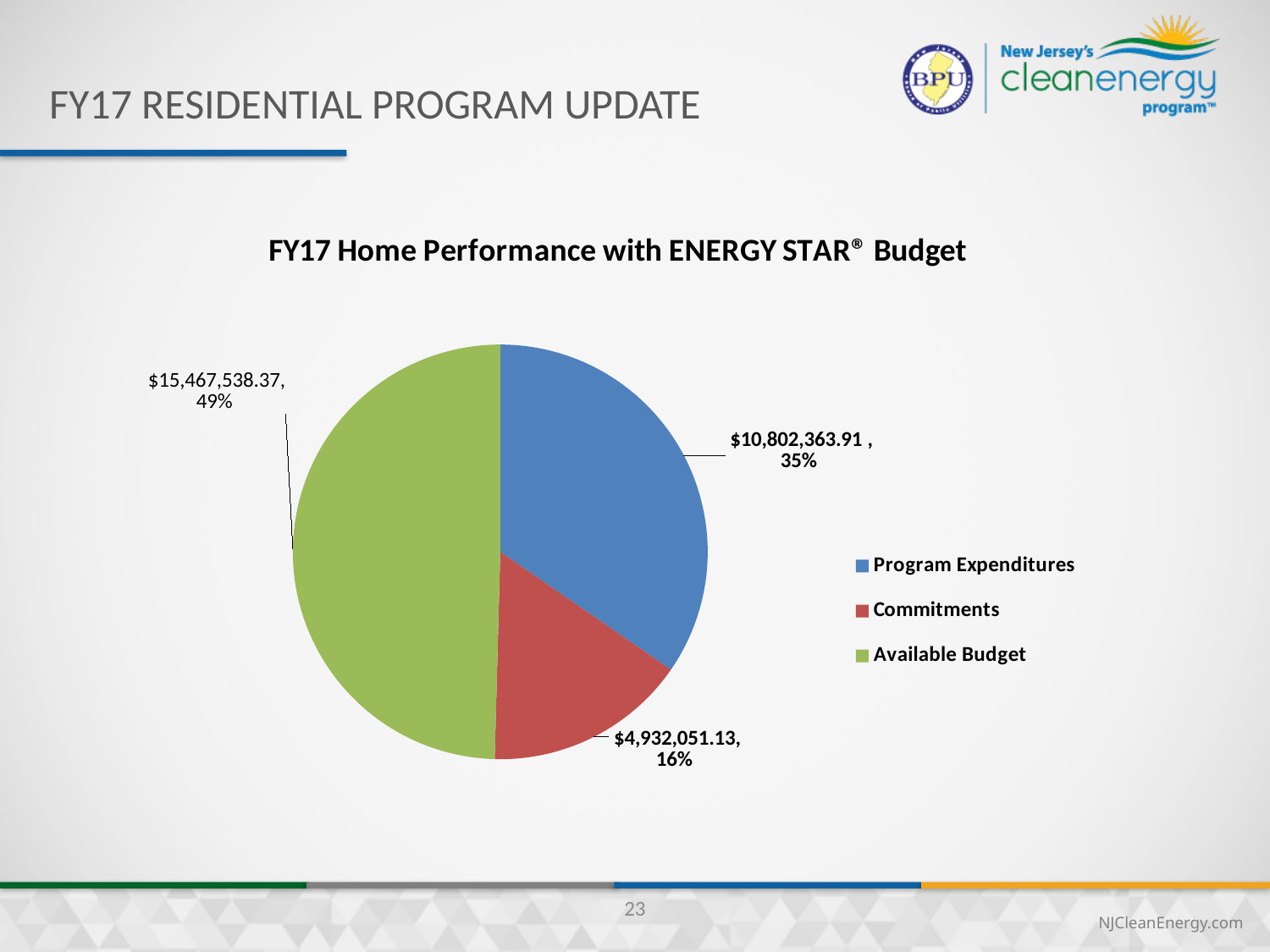
What share of the pie does Commitments represent? 16% What is the value for Program Expenditures? $10,802,363.91 How many slices does the pie chart have? 3 What type of chart is shown on the slide? Pie chart Which category has the largest slice? Available Budget What is the title of the chart? FY17 Home Performance with ENERGY STAR® Budget Which category has the smallest slice? Commitments What is the value for Available Budget? $15,467,538.37 What is the value for Commitments? $4,932,051.13 What share of the pie does Available Budget represent? 49% Which is larger, Program Expenditures or Commitments? Program Expenditures How many entries does the legend list? 3